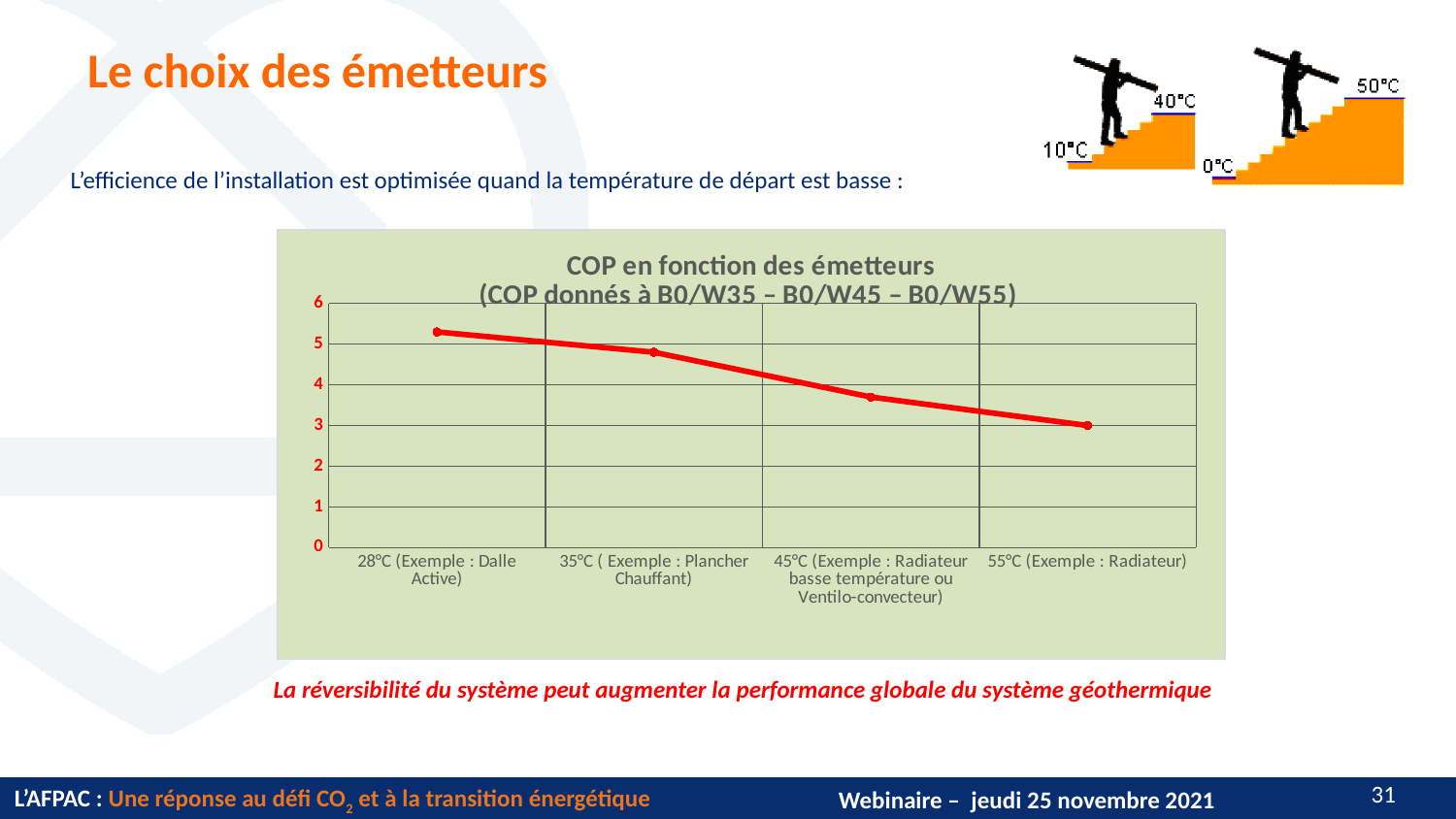
Which category has the highest COP value? 28°C (Exemple : Dalle Active) How many categories are plotted along the x axis of the chart? 4 What colour is the line plotted on the chart? red Do the COP values rise or fall as the departure temperature increases along the x axis? fall Is the COP value for 35°C (Exemple : Plancher Chauffant) greater or less than 4? greater Is the COP value for 55°C (Exemple : Radiateur) greater or less than 4? less What is the title of the chart? COP en fonction des émetteurs (COP donnés à B0/W35 – B0/W45 – B0/W55) What kind of chart is shown on the slide? line chart Which has the larger COP value: 35°C (Exemple : Plancher Chauffant) or 45°C (Exemple : Radiateur basse température ou Ventilo-convecteur)? 35°C (Exemple : Plancher Chauffant) Which category has the lowest COP value? 55°C (Exemple : Radiateur) Is the COP value for 28°C (Exemple : Dalle Active) greater or less than 5? greater